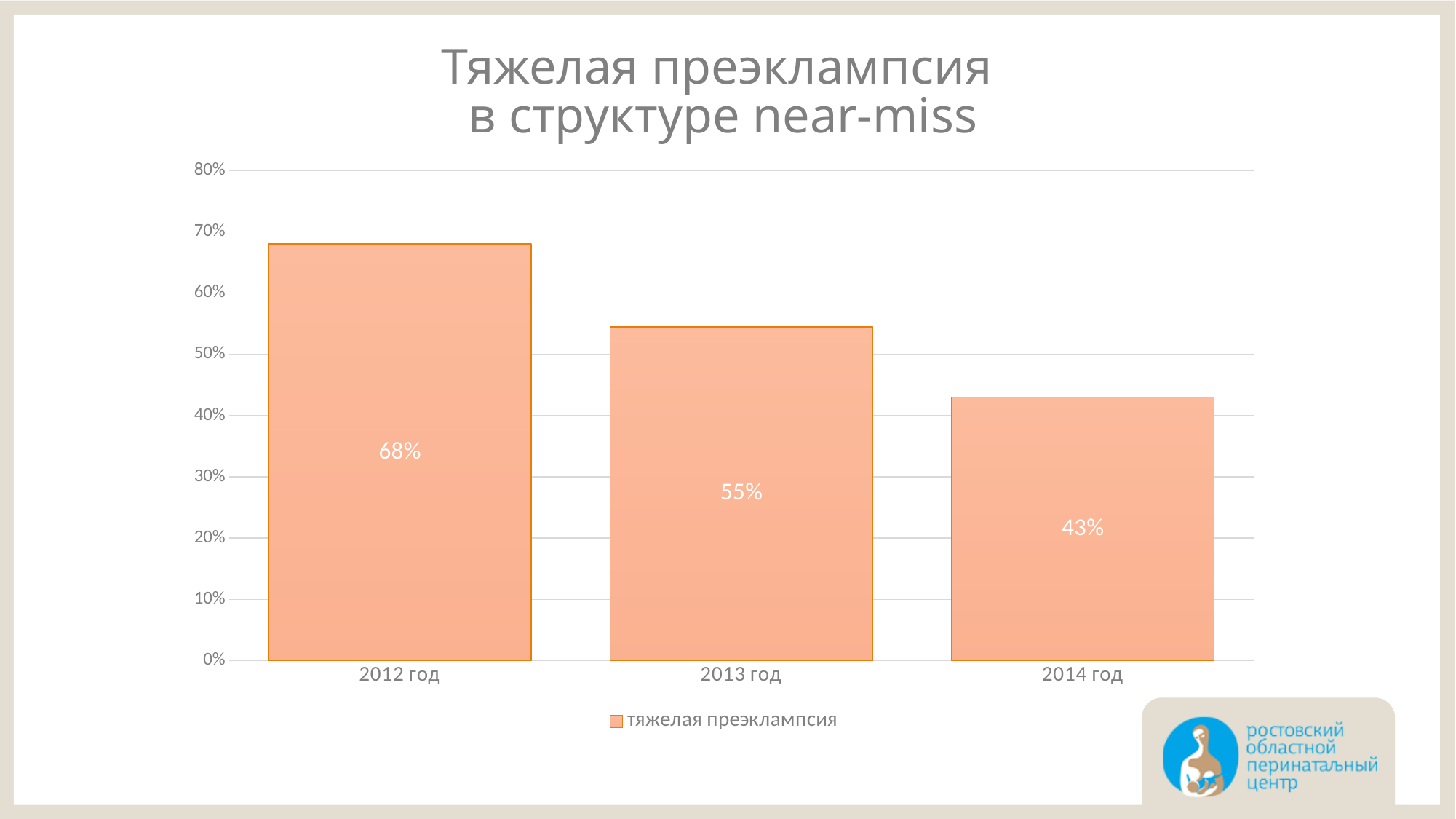
What is the value for 2013 год? 55% Is the value for 2013 год greater or less than 50%? greater Which year has the highest value? 2012 год Which year has the lowest value? 2014 год How many years are shown on the x axis? 3 What is the value for 2014 год? 43% Which is larger, the value for 2013 год or the value for 2014 год? 2013 год What is the value for 2012 год? 68% Do the values rise or fall from 2012 год to 2014 год? fall What is the difference between the values for 2012 год and 2014 год? 25% What is the difference between the values for 2012 год and 2013 год? 13% What kind of chart is shown on the slide? bar chart